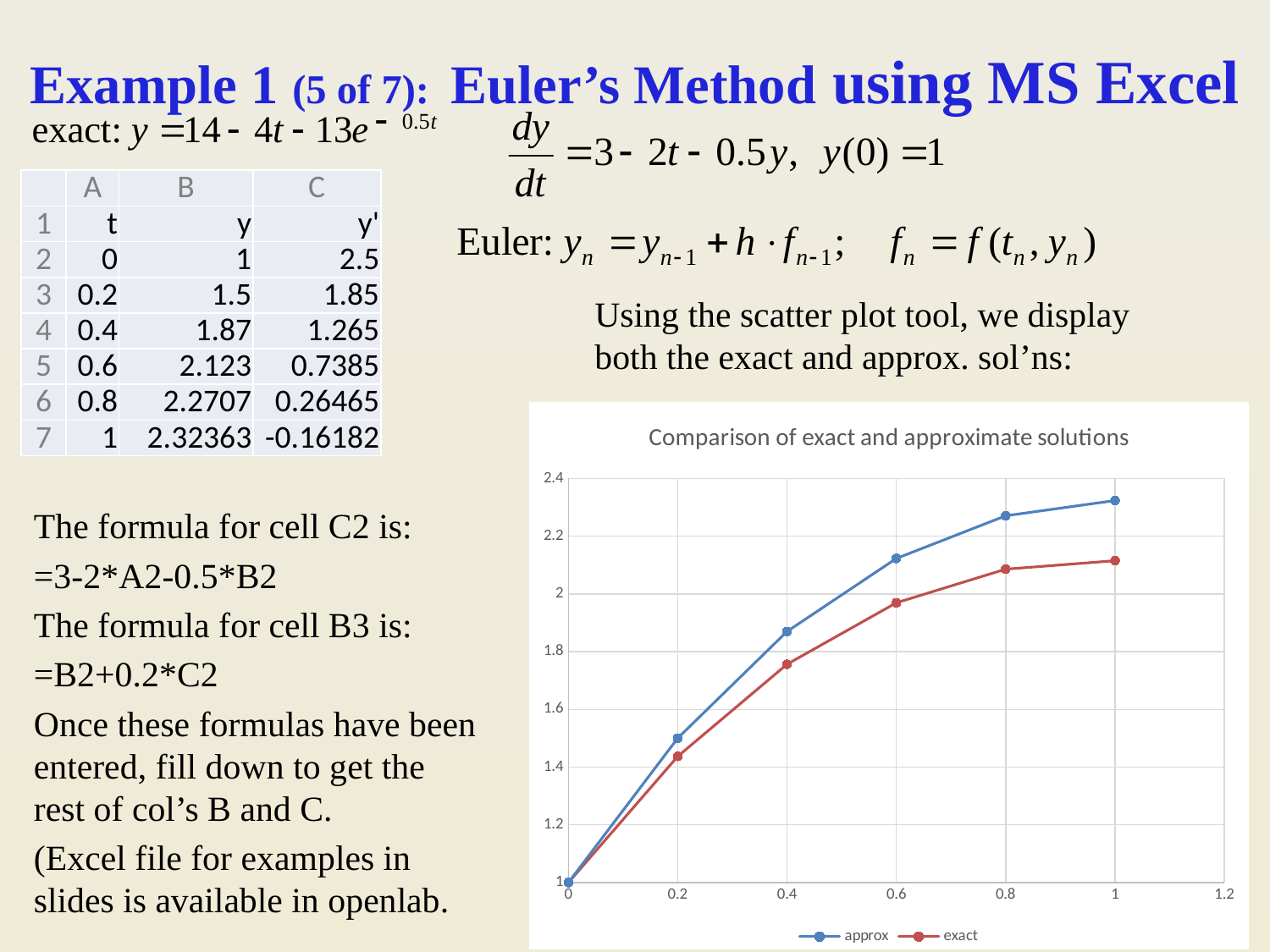
Is the value of the exact series at t = 1 greater or less than 2.2? less How many series does the chart legend list? 2 Do the values of the exact series rise or fall as t increases from 0 to 1? rise What is the value of both series at t = 0? 1 What kind of chart is shown on the slide? scatter plot At t = 0.6, which series has the higher value, approx or exact? approx How many data points are plotted for the approx series? 6 What are the two series named in the chart legend? approx and exact Is the value of the exact series at t = 0.4 greater or less than 1.6? greater What is the title of the chart? Comparison of exact and approximate solutions Is the value of the approx series at t = 1 greater or less than 2.2? greater What is the value of the approx series at t = 0.2? 1.5